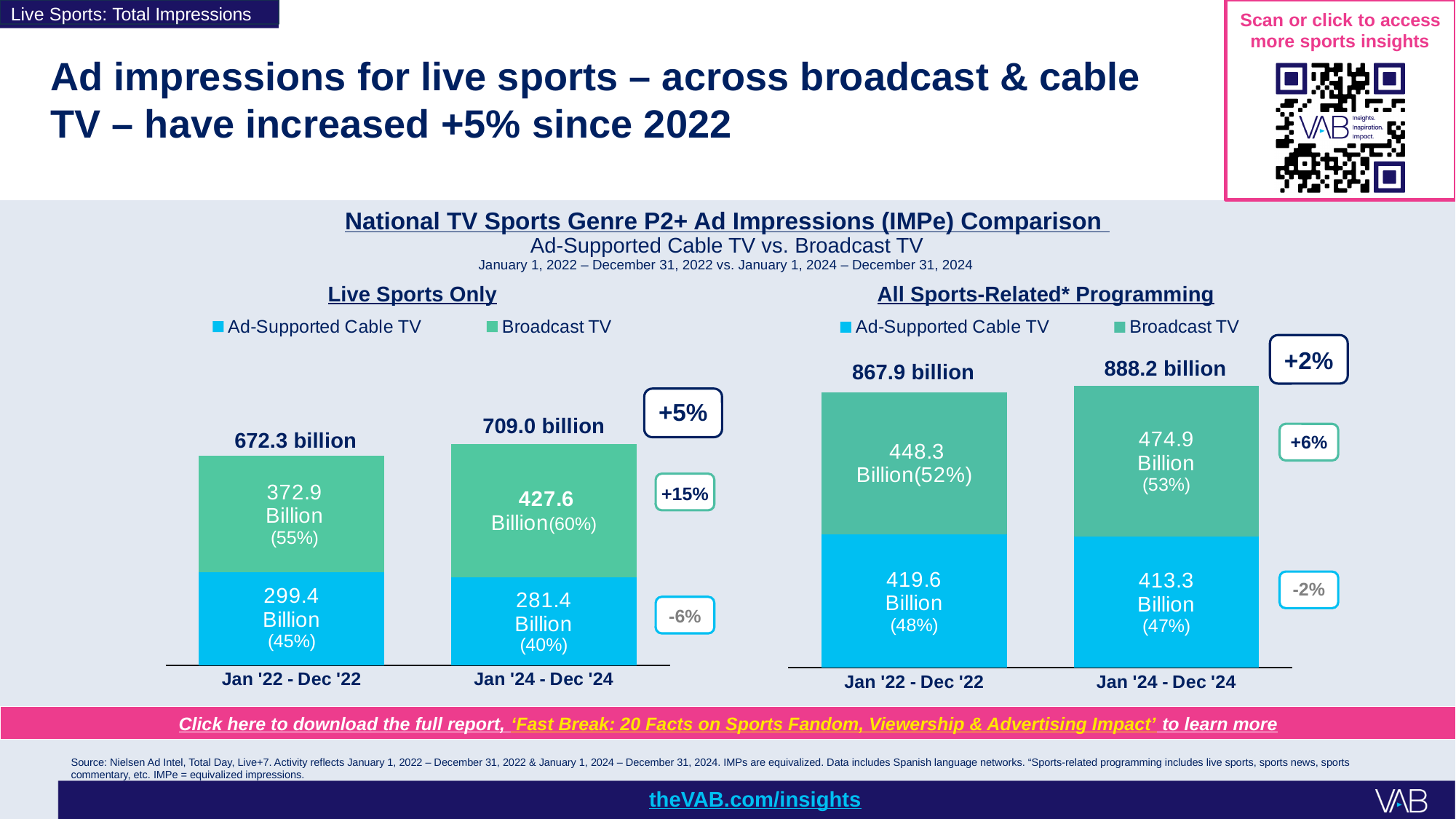
In the Live Sports Only chart, what is the difference between the Broadcast TV values for Jan '24 - Dec '24 and Jan '22 - Dec '22? 54.7 Billion In the All Sports-Related* Programming chart, what is the total of the stacked bar for Jan '22 - Dec '22? 867.9 billion In the Live Sports Only chart, what share of the Jan '24 - Dec '24 bar is Broadcast TV? 60% In the All Sports-Related* Programming chart, what is the Broadcast TV value for Jan '22 - Dec '22? 448.3 Billion In the Live Sports Only chart, does the Ad-Supported Cable TV value rise or fall from Jan '22 - Dec '22 to Jan '24 - Dec '24? fall In the Live Sports Only chart, what is the Ad-Supported Cable TV value for Jan '22 - Dec '22? 299.4 Billion In the All Sports-Related* Programming chart, which is larger for Jan '24 - Dec '24: Ad-Supported Cable TV or Broadcast TV? Broadcast TV In the Live Sports Only chart, what is the total of the stacked bar for Jan '24 - Dec '24? 709.0 billion In the All Sports-Related* Programming chart, what is the Ad-Supported Cable TV value for Jan '24 - Dec '24? 413.3 Billion In the Live Sports Only chart, what is the Broadcast TV value for Jan '24 - Dec '24? 427.6 Billion What kind of chart is the Live Sports Only chart? stacked bar chart How many series does the legend of the All Sports-Related* Programming chart list? 2